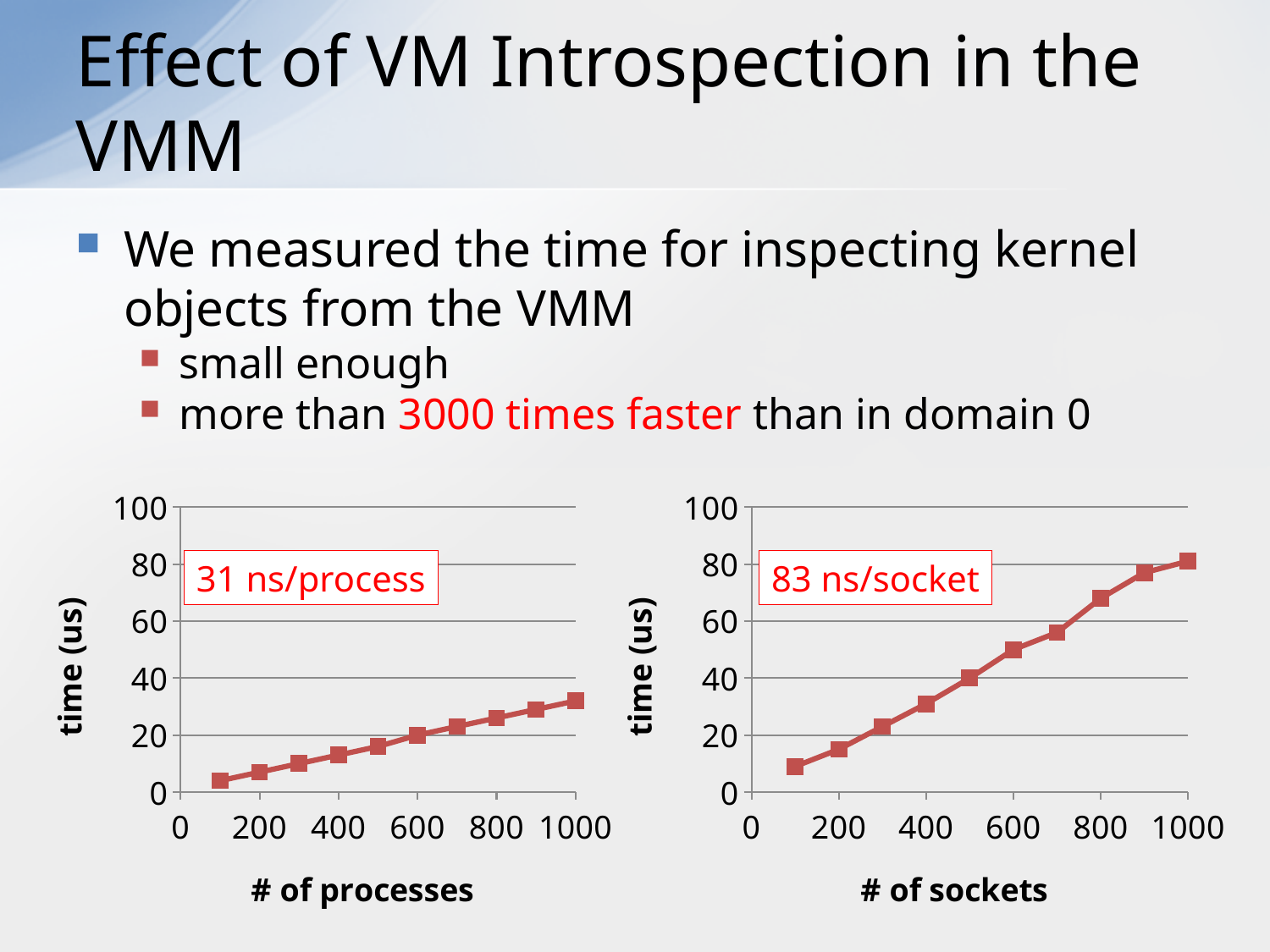
In the left chart ('# of processes'), which number of processes has the highest time? 1000 In the right chart ('# of sockets'), does the time rise or fall as the number of sockets increases? rise In the right chart ('# of sockets'), is the time for 600 sockets greater or less than 40 us? greater What is the y-axis label of the left chart ('# of processes')? time (us) In the right chart ('# of sockets'), is the time for 800 sockets greater or less than 60 us? greater What per-item rate is annotated on the right chart ('# of sockets')? 83 ns/socket In the right chart ('# of sockets'), is the time for 200 sockets greater or less than 20 us? less How many data points are plotted in the right chart ('# of sockets')? 10 Which is larger at 1000 objects: the time in the left chart ('# of processes') or the time in the right chart ('# of sockets')? # of sockets What kind of chart is the left chart, '# of processes'? line chart How many data points are plotted in the left chart ('# of processes')? 10